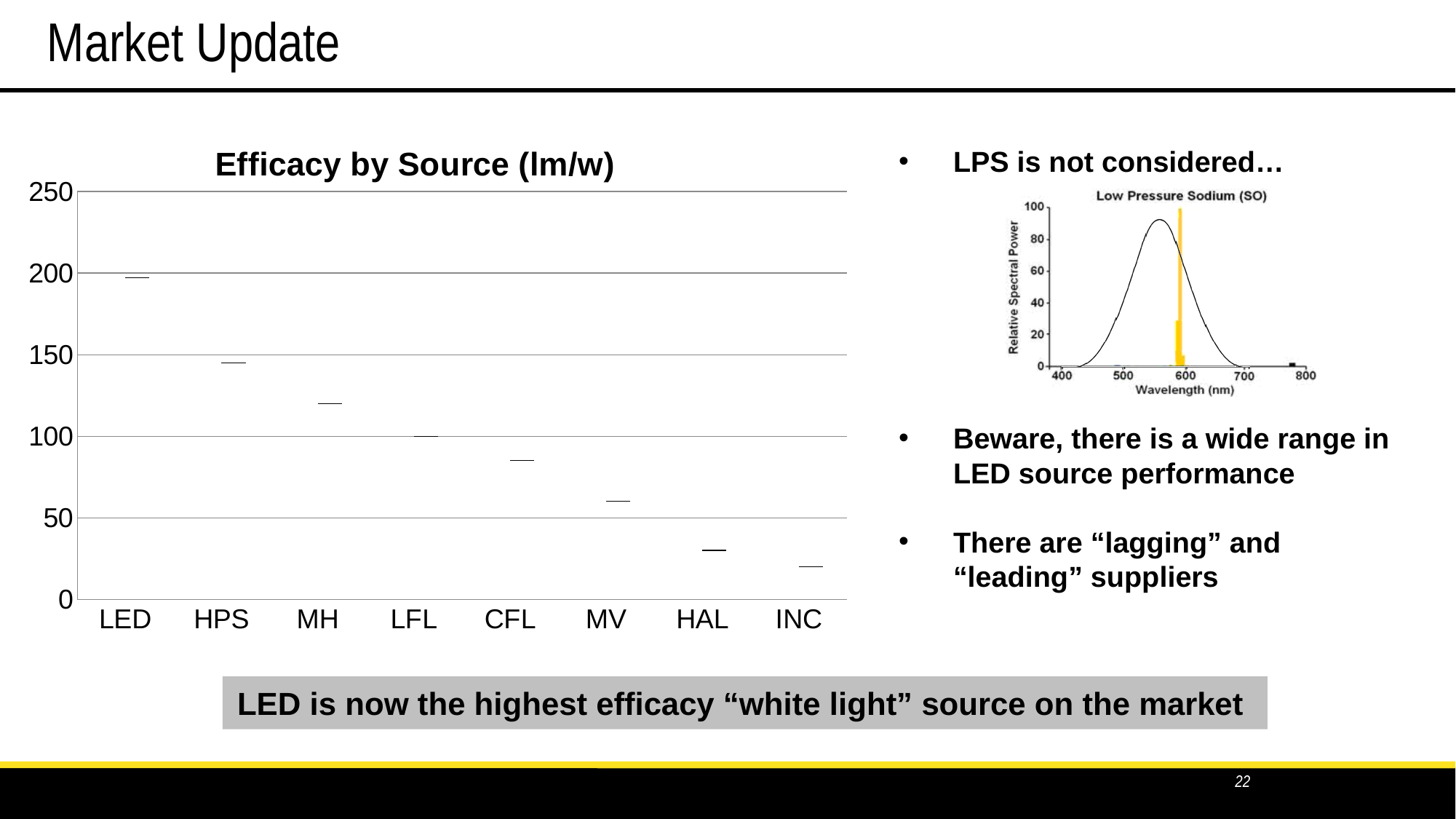
In the Efficacy by Source (lm/w) chart, is the value for MH greater or less than 100? greater In the Efficacy by Source (lm/w) chart, is the value for CFL greater or less than 100? less In the Efficacy by Source (lm/w) chart, which source has the highest efficacy? LED In the Efficacy by Source (lm/w) chart, is the value for HAL greater or less than 50? less In the Efficacy by Source (lm/w) chart, what is the efficacy value for LFL? 100 How many sources are plotted on the x axis of the Efficacy by Source (lm/w) chart? 8 In the Efficacy by Source (lm/w) chart, do the values rise or fall moving from LED to INC along the x axis? fall In the Efficacy by Source (lm/w) chart, which has the higher efficacy, HPS or MH? HPS What is the title of the chart on the left of the slide? Efficacy by Source (lm/w) In the Efficacy by Source (lm/w) chart, which source has the lowest efficacy? INC